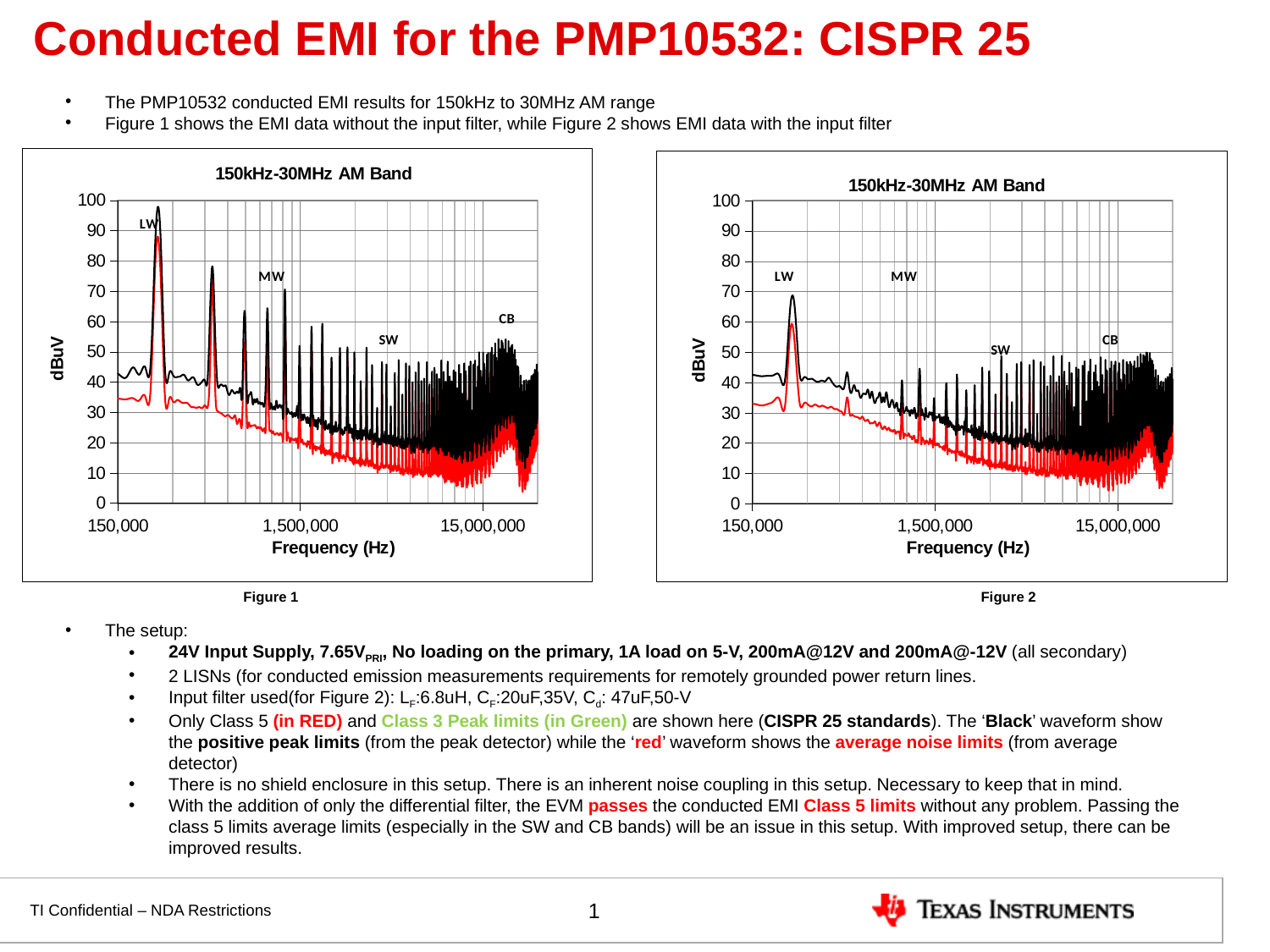
What is the x-axis tick value shown at the far left of the Figure 2 chart? 150,000 In Figure 2, does the red trace generally rise or fall as frequency increases from 150,000 Hz to 15,000,000 Hz? fall Which chart has the higher maximum peak on the black trace, Figure 1 or Figure 2? Figure 1 In Figure 2, is the highest peak of the black trace greater or less than 70 dBuV? less What is the y-axis label on the Figure 1 chart? dBuV In Figure 1, is the highest peak of the red trace greater or less than 80 dBuV? greater In Figure 1, is the highest peak of the black trace greater or less than 90 dBuV? greater What kind of chart is Figure 1? line chart What is the title of the chart in Figure 2? 150kHz-30MHz AM Band In Figure 1, which band label is placed near the highest peak? LW How many charts are shown on the slide? 2